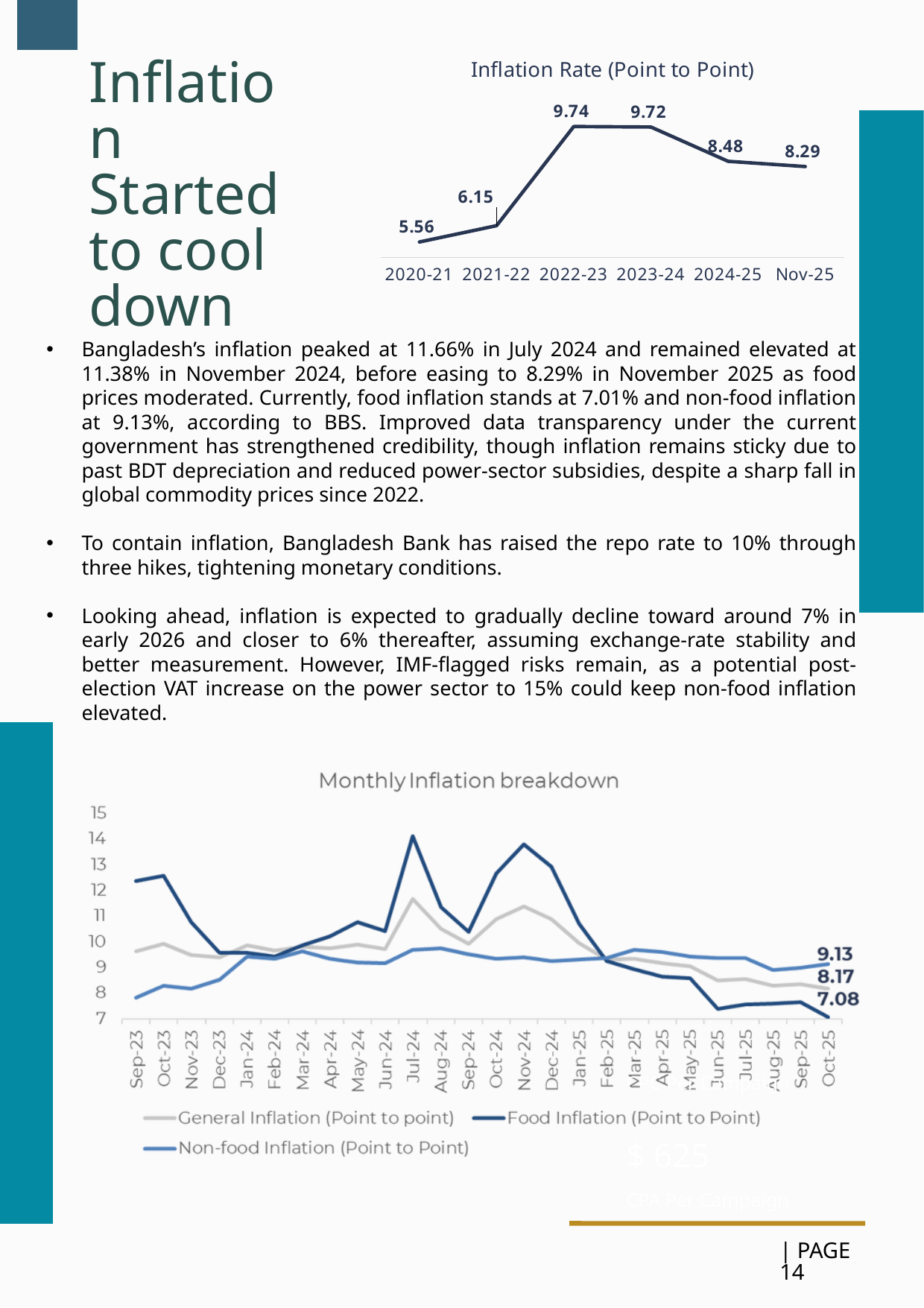
In the 'Monthly Inflation breakdown' chart, what is the value of Non-food Inflation (Point to Point) at Oct-25? 9.13 How many series does the legend of the 'Monthly Inflation breakdown' chart list? 3 In the 'Inflation Rate (Point to Point)' chart, what is the value for 2022-23? 9.74 In the 'Monthly Inflation breakdown' chart, is the value of Food Inflation (Point to Point) at Jul-24 greater or less than 13? greater What type of chart is the 'Inflation Rate (Point to Point)' chart? Line chart In the 'Inflation Rate (Point to Point)' chart, which period has the lowest value? 2020-21 In the 'Inflation Rate (Point to Point)' chart, what is the difference between the 2024-25 value and the Nov-25 value? 0.19 In the 'Inflation Rate (Point to Point)' chart, which period has the highest value? 2022-23 How many periods are plotted in the 'Inflation Rate (Point to Point)' chart? 6 In the 'Inflation Rate (Point to Point)' chart, what is the value for Nov-25? 8.29 In the 'Inflation Rate (Point to Point)' chart, which is larger, the value for 2021-22 or the value for 2024-25? 2024-25 In the 'Monthly Inflation breakdown' chart, which series has the lowest value at Oct-25? Food Inflation (Point to Point)